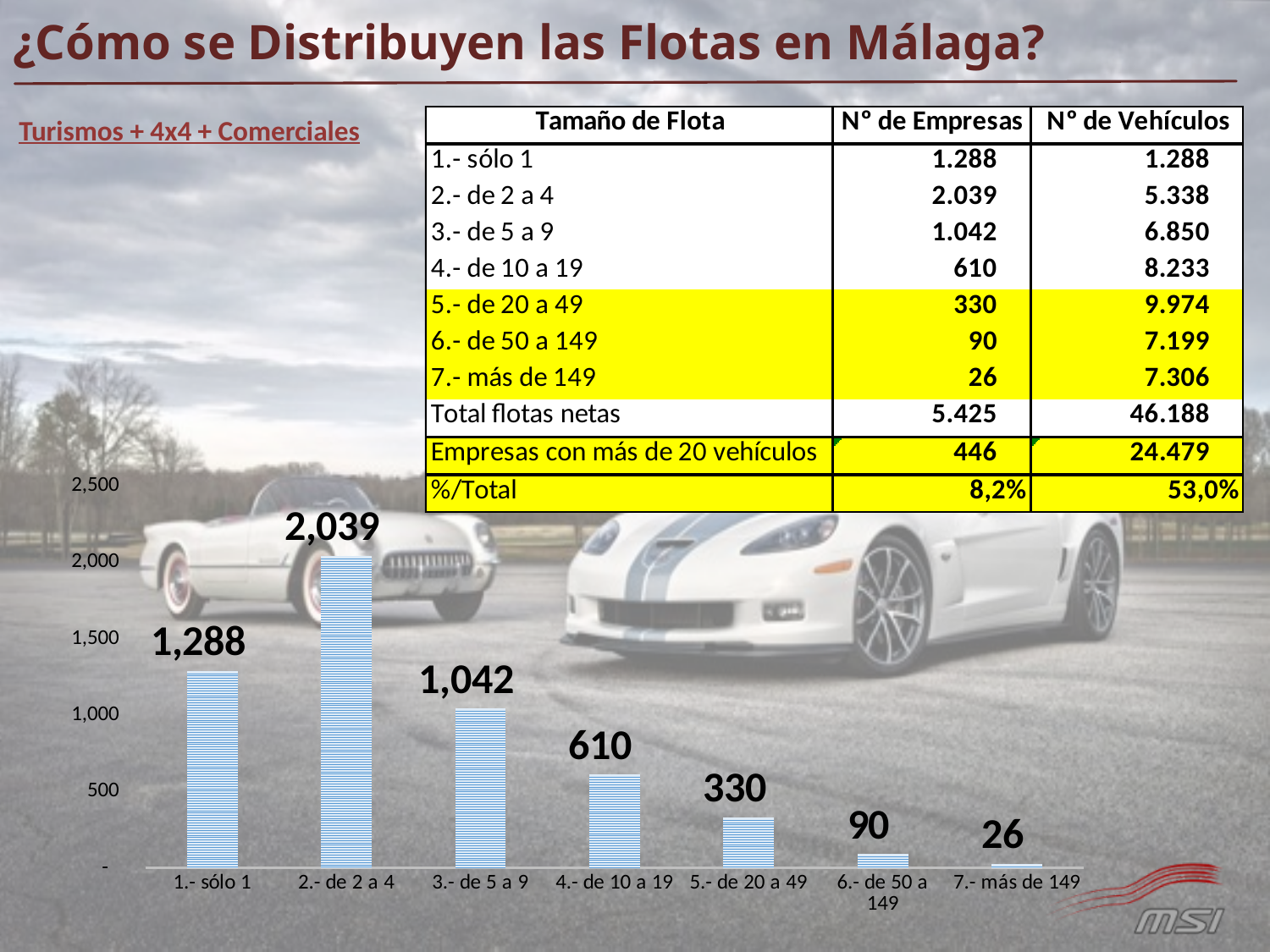
What value does the bar chart show for the category "2.- de 2 a 4"? 2,039 What value does the bar chart show for "4.- de 10 a 19"? 610 How many categories are shown on the x axis of the bar chart? 7 In the bar chart, what is the difference between the values for "5.- de 20 a 49" and "6.- de 50 a 149"? 240 What kind of chart is shown at the bottom of the slide? bar chart Which category has the lowest bar in the bar chart? 7.- más de 149 In the bar chart, which is larger: the value for "3.- de 5 a 9" or the value for "4.- de 10 a 19"? 3.- de 5 a 9 From "2.- de 2 a 4" to "7.- más de 149", do the bar values rise or fall along the x axis? fall What value does the bar chart show for "7.- más de 149"? 26 Is the value for "1.- sólo 1" in the bar chart greater or less than 1,000? greater Which category has the highest bar in the bar chart? 2.- de 2 a 4 In the bar chart, what is the difference between the values for "2.- de 2 a 4" and "1.- sólo 1"? 751